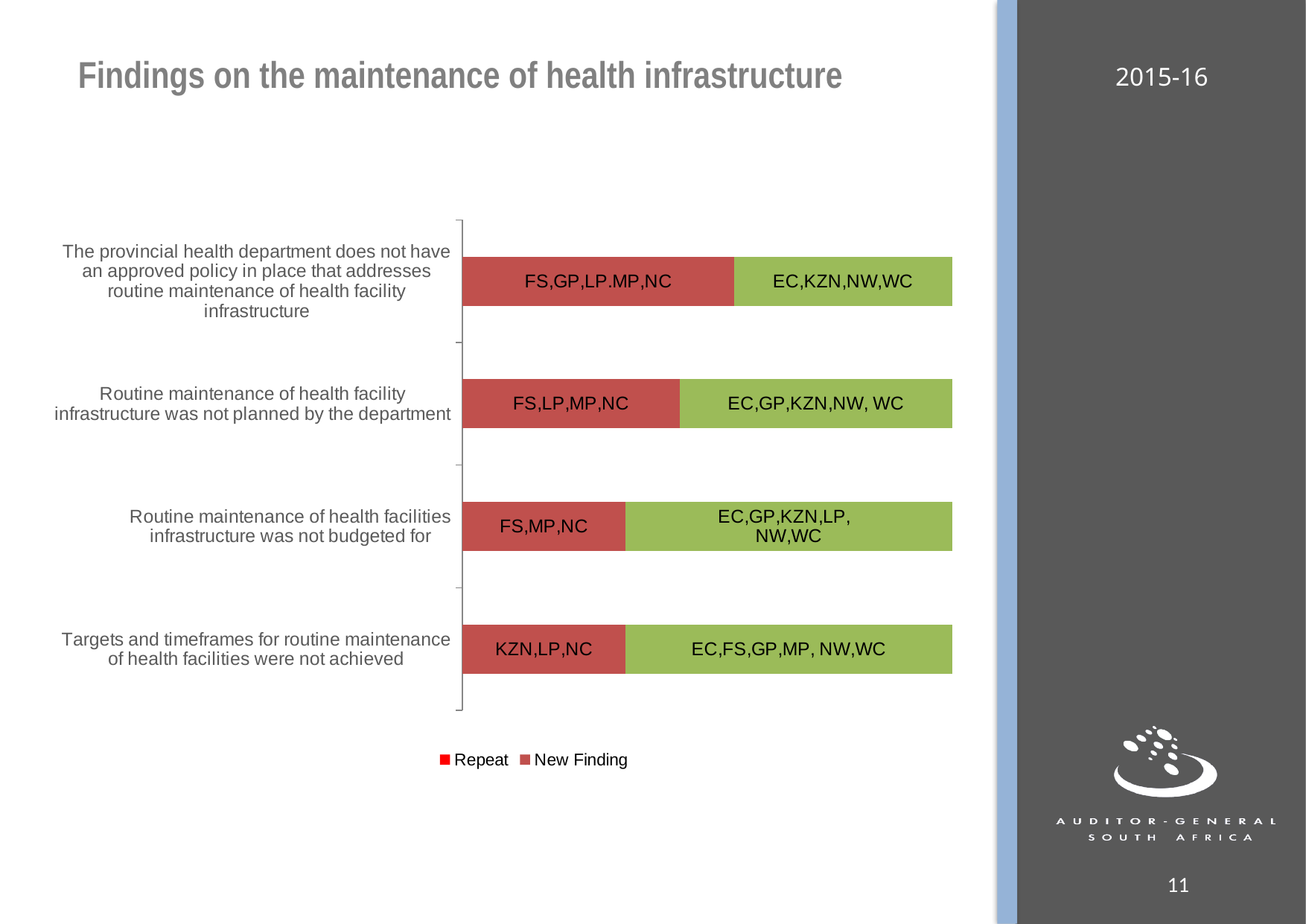
Which provinces are listed in the red segment of the bar for 'Routine maintenance of health facility infrastructure was not planned by the department'? FS,LP,MP,NC Which provinces are listed in the red segment of the bar for 'Routine maintenance of health facilities infrastructure was not budgeted for'? FS,MP,NC What is the title of the slide containing the chart? Findings on the maintenance of health infrastructure How many provinces are listed in the red segment of the bar for 'The provincial health department does not have an approved policy in place that addresses routine maintenance of health facility infrastructure'? 5 What are the two entries in the chart legend? Repeat and New Finding How many series does the legend list? 2 Which provinces are listed in the green segment of the bar for 'The provincial health department does not have an approved policy in place that addresses routine maintenance of health facility infrastructure'? EC,KZN,NW,WC Which provinces are listed in the green segment of the bar for 'Targets and timeframes for routine maintenance of health facilities were not achieved'? EC,FS,GP,MP, NW,WC For the finding 'Routine maintenance of health facilities infrastructure was not budgeted for', is the red segment or the green segment wider? Green segment How many findings (categories) are plotted on the chart? 4 What kind of chart is shown on the slide? Bar chart Which provinces are listed in the red segment of the bar for 'Targets and timeframes for routine maintenance of health facilities were not achieved'? KZN,LP,NC